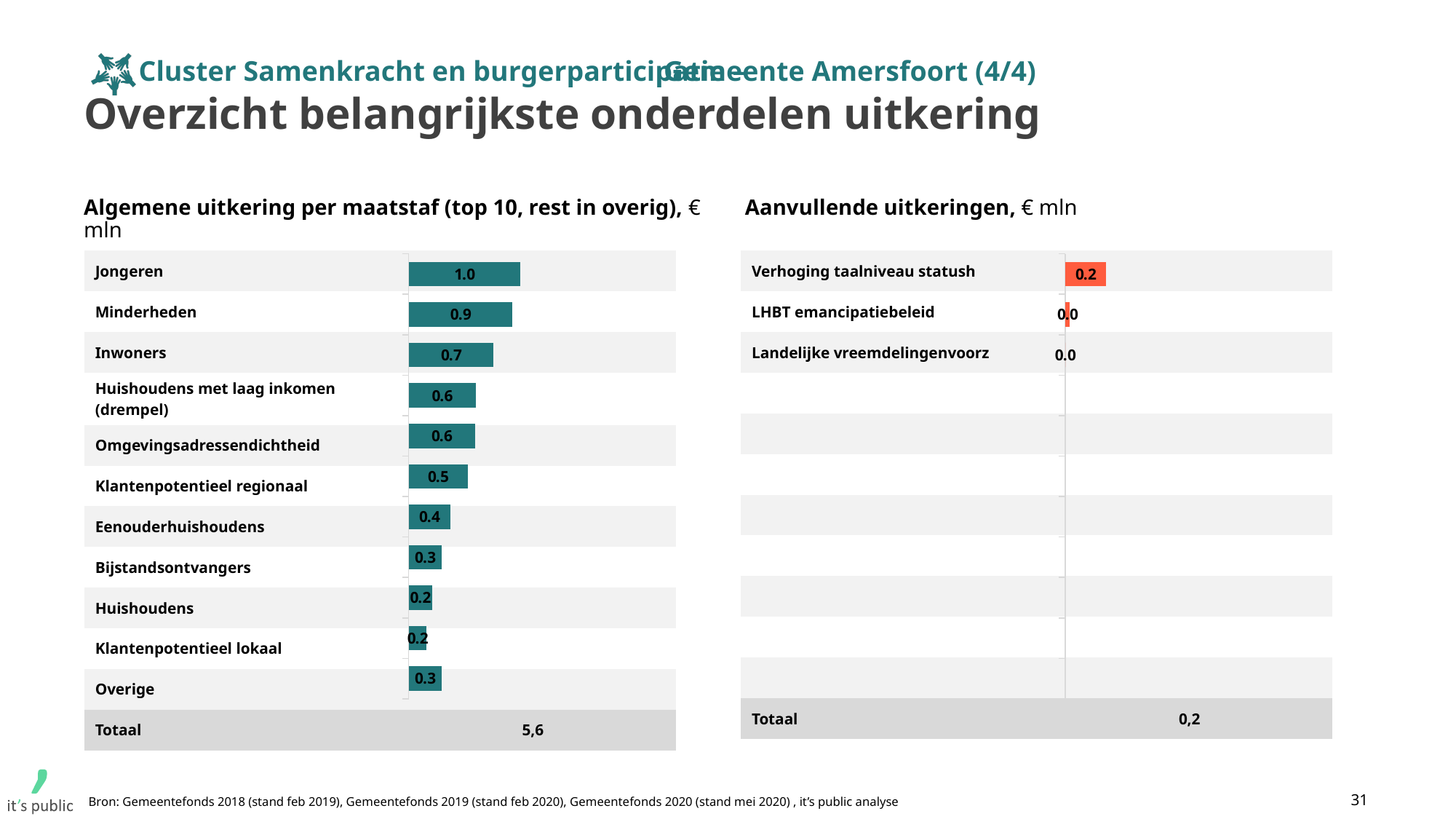
In the 'Algemene uitkering per maatstaf' chart, what is the value for Eenouderhuishoudens? 0.4 What type of chart is the 'Aanvullende uitkeringen' chart? Bar chart In the 'Aanvullende uitkeringen' chart, how many categories are shown? 3 In the 'Algemene uitkering per maatstaf' chart, what is the value for Jongeren? 1.0 In the 'Aanvullende uitkeringen' chart, what is the value for LHBT emancipatiebeleid? 0.0 In the 'Algemene uitkering per maatstaf' chart, what is the value for Inwoners? 0.7 In the 'Algemene uitkering per maatstaf' chart, which is larger: Inwoners or Klantenpotentieel regionaal? Inwoners In the 'Algemene uitkering per maatstaf' chart, what is the difference between Jongeren and Minderheden? 0.1 What is the Totaal shown for the 'Algemene uitkering per maatstaf' chart? 5,6 In the 'Algemene uitkering per maatstaf' chart, how many categories are shown (including Overige)? 11 In the 'Algemene uitkering per maatstaf' chart, which category has the highest value? Jongeren In the 'Aanvullende uitkeringen' chart, what is the value for Verhoging taalniveau statush? 0.2